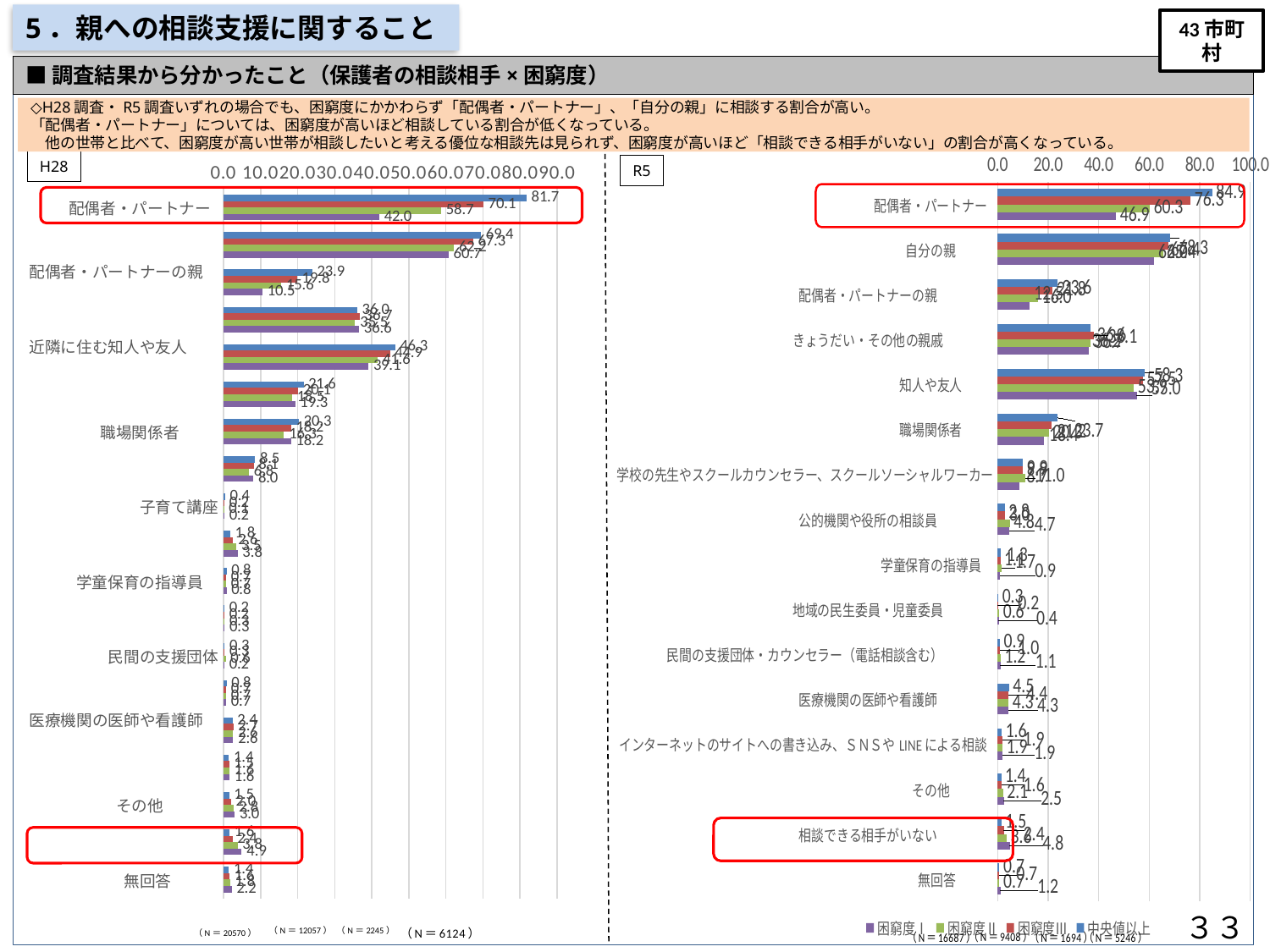
In the H28 chart, what is the value for 配偶者・パートナー for the 困窮度Ⅰ series? 42.0 In the R5 chart, is the 中央値以上 value for 自分の親 greater or less than 60.0? greater In the H28 chart, what is the difference between the 中央値以上 and 困窮度Ⅰ values for 配偶者・パートナー? 39.7 In the R5 chart, what is the value for 配偶者・パートナー for the 中央値以上 series? 84.9 In the R5 chart, what is the difference between the 中央値以上 and 困窮度Ⅰ values for 配偶者・パートナー? 38.0 In the H28 chart, what is the value for 配偶者・パートナー for the 中央値以上 series? 81.7 How many series does the legend at the bottom of the R5 chart list? 4 What kind of chart is the R5 chart on the right side of the slide? bar chart How many categories are shown on the R5 chart? 16 In the R5 chart, for 配偶者・パートナー, which is larger: the 中央値以上 value or the 困窮度Ⅰ value? 中央値以上 In the R5 chart, what is the value for 配偶者・パートナー for the 困窮度Ⅰ series? 46.9 In the R5 chart, which category has the highest value? 配偶者・パートナー